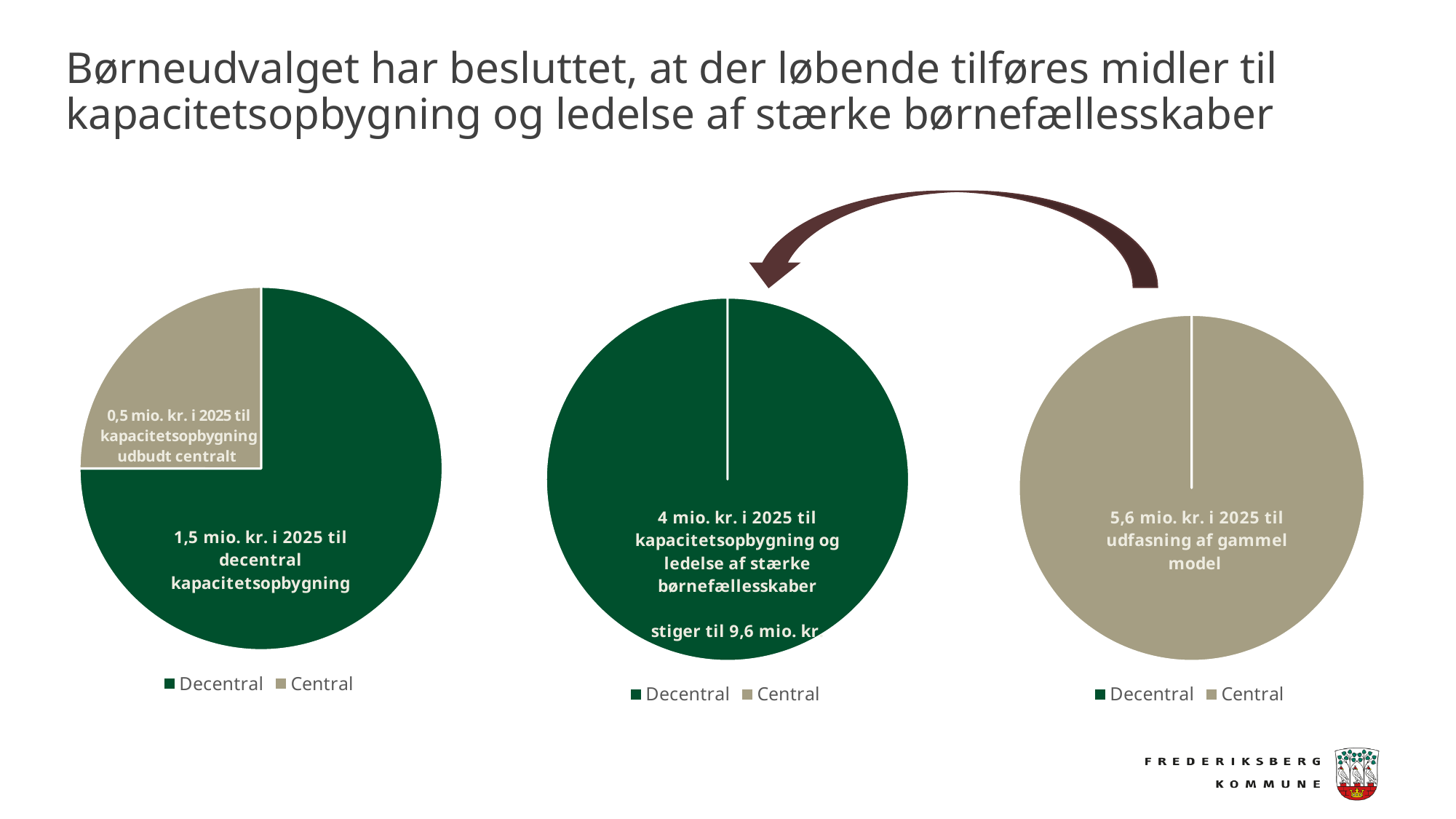
According to the middle pie chart's label, what amount does the 4 mio. kr. rise to? 9,6 mio. kr How many entries does the legend of the middle pie chart list? 2 What kind of charts are shown on the slide? Pie charts Which legend entry is shown in green in the pie charts? Decentral In the left pie chart, what is the difference between the Decentral amount and the Central amount? 1 mio. kr. In the left pie chart, what amount is labelled for decentral kapacitetsopbygning in 2025? 1,5 mio. kr. In the right pie chart, what amount is labelled for udfasning af gammel model in 2025? 5,6 mio. kr. In the left pie chart, which slice is larger, Decentral or Central? Decentral In the left pie chart, what amount is labelled for kapacitetsopbygning udbudt centralt in 2025? 0,5 mio. kr. In the middle pie chart, what amount is labelled for kapacitetsopbygning og ledelse af stærke børnefællesskaber in 2025? 4 mio. kr. How many pie charts are on the slide? 3 In the left pie chart, what share of the pie does the Central slice represent? 25%